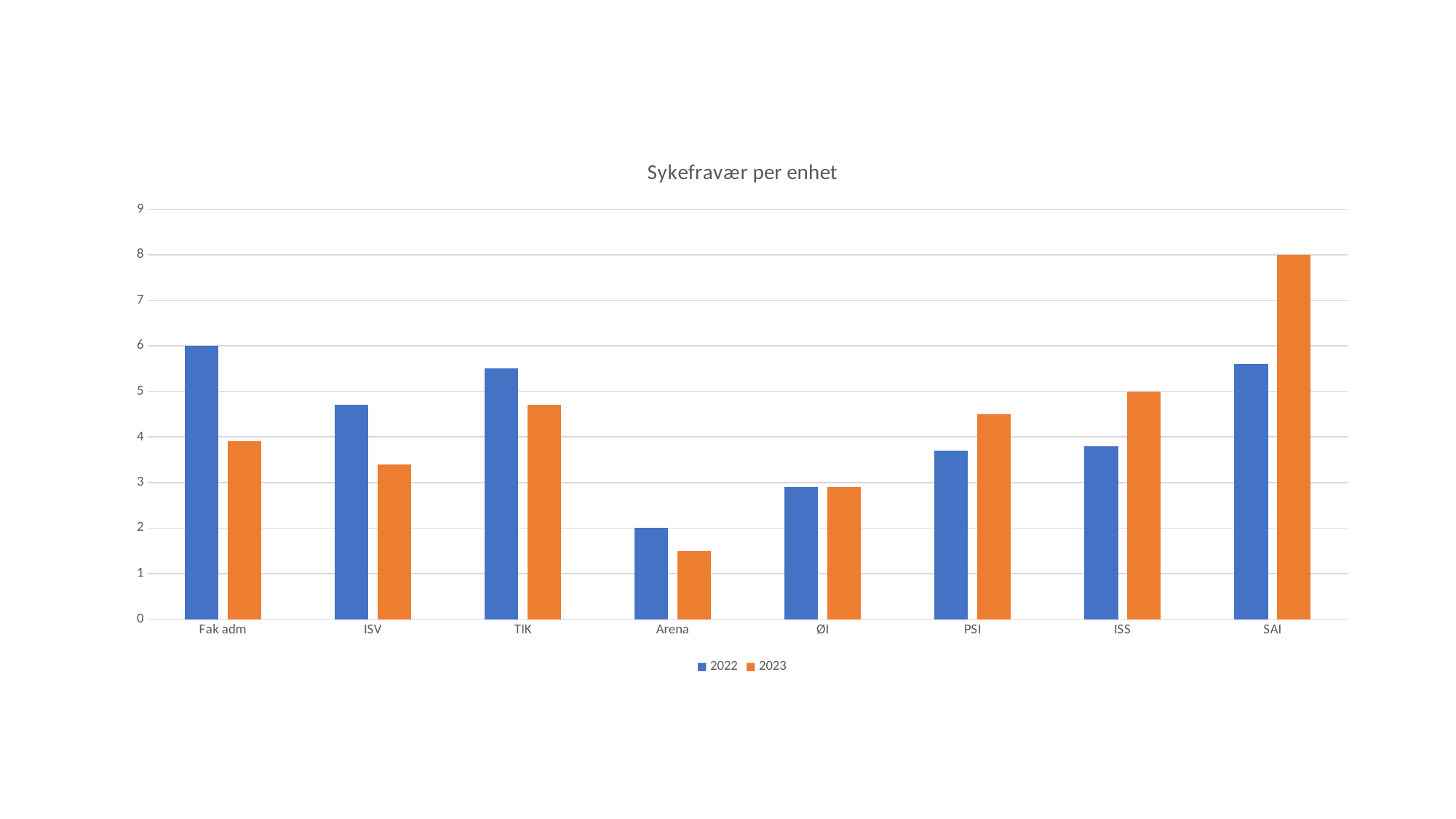
What is the 2022 value for Arena? 2 What kind of chart is shown on the slide? bar chart What is the 2022 value for Fak adm? 6 How many series does the legend list? 2 Which unit has the lowest 2022 value? Arena Is the 2023 value for ISV greater or less than 4? less How many units (categories) are shown on the x axis? 8 What is the 2023 value for SAI? 8 Which is larger for PSI, the 2022 value or the 2023 value? 2023 Which unit has the highest 2023 value? SAI What is the title of the chart? Sykefravær per enhet Is the 2022 value for TIK greater or less than 5? greater